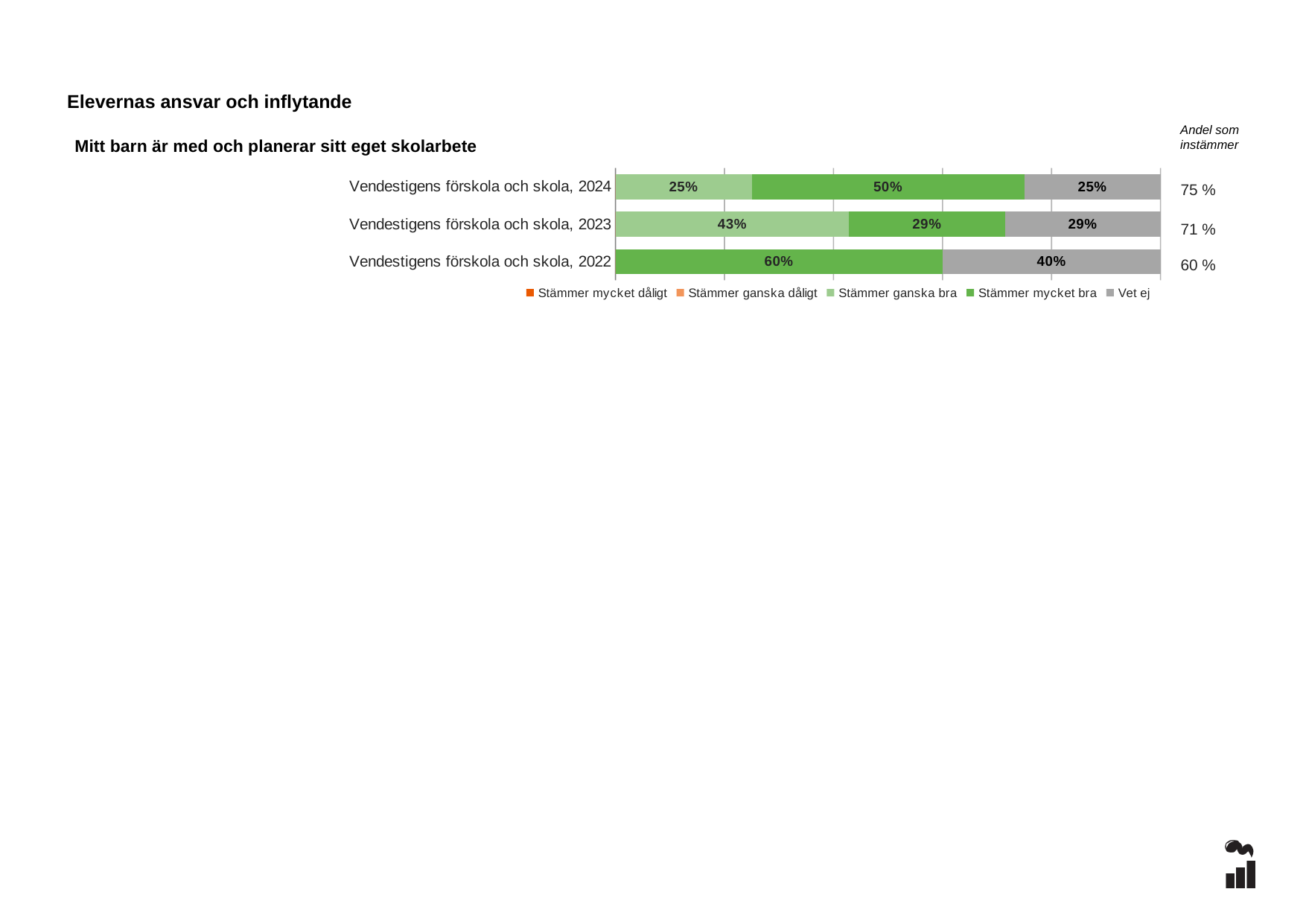
Which year has the highest "Andel som instämmer" value? 2024 Which is larger: the "Vet ej" share in 2023 or in 2024? 2023 Which year has the lowest "Stämmer mycket bra" share? 2023 What kind of chart is shown on the slide? Stacked bar chart What percentage of respondents for Vendestigens förskola och skola, 2024 answered "Stämmer mycket bra"? 50% What percentage of respondents for Vendestigens förskola och skola, 2023 answered "Stämmer ganska bra"? 43% What is the title of the question shown above the chart? Mitt barn är med och planerar sitt eget skolarbete What is the "Andel som instämmer" value shown for Vendestigens förskola och skola, 2023? 71 % What is the "Vet ej" share for Vendestigens förskola och skola, 2022? 40% How many series does the legend list? 5 How many bars (rows) does the chart show? 3 What is the difference between the "Stämmer mycket bra" share in 2022 and in 2024? 10%